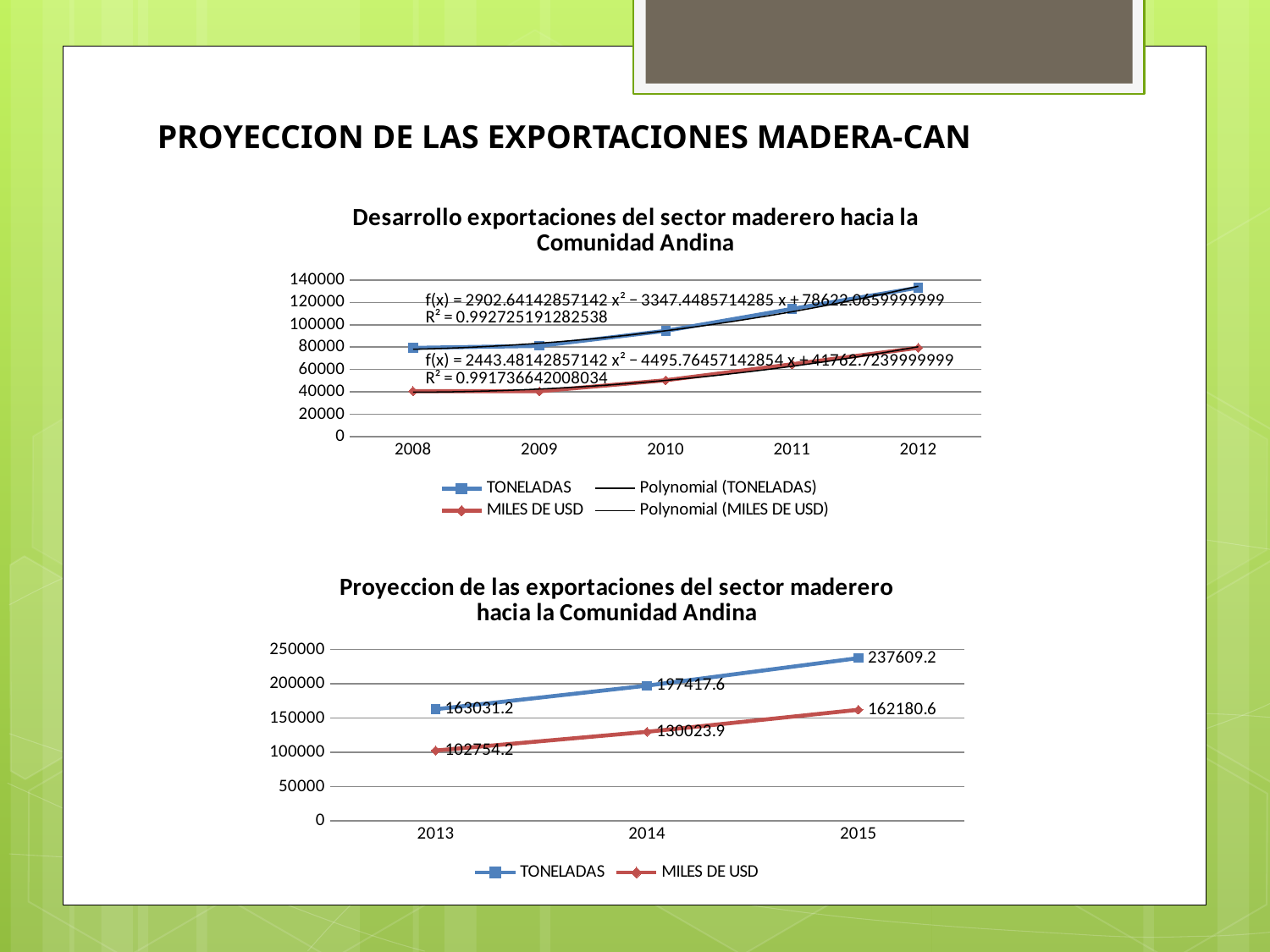
In the bottom chart (Proyeccion de las exportaciones), what is the difference between the TONELADAS values for 2015 and 2013? 74578 In the bottom chart (Proyeccion de las exportaciones), which is larger in 2014: TONELADAS or MILES DE USD? TONELADAS In the bottom chart (Proyeccion de las exportaciones), do the MILES DE USD values rise or fall from 2013 to 2015? rise How many entries does the legend of the top chart (Desarrollo exportaciones) list? 4 In the bottom chart (Proyeccion de las exportaciones), what is the MILES DE USD value for 2013? 102754.2 In the top chart (Desarrollo exportaciones), is the TONELADAS value for 2012 greater or less than 120000? greater How many years are shown on the x axis of the top chart (Desarrollo exportaciones)? 5 In the bottom chart (Proyeccion de las exportaciones), what is the TONELADAS value for 2015? 237609.2 In the top chart (Desarrollo exportaciones), is the TONELADAS value for 2008 greater or less than 100000? less In the bottom chart (Proyeccion de las exportaciones), what is the MILES DE USD value for 2014? 130023.9 In the bottom chart (Proyeccion de las exportaciones), which year has the lowest MILES DE USD value? 2013 In the bottom chart (Proyeccion de las exportaciones), which year has the highest TONELADAS value? 2015